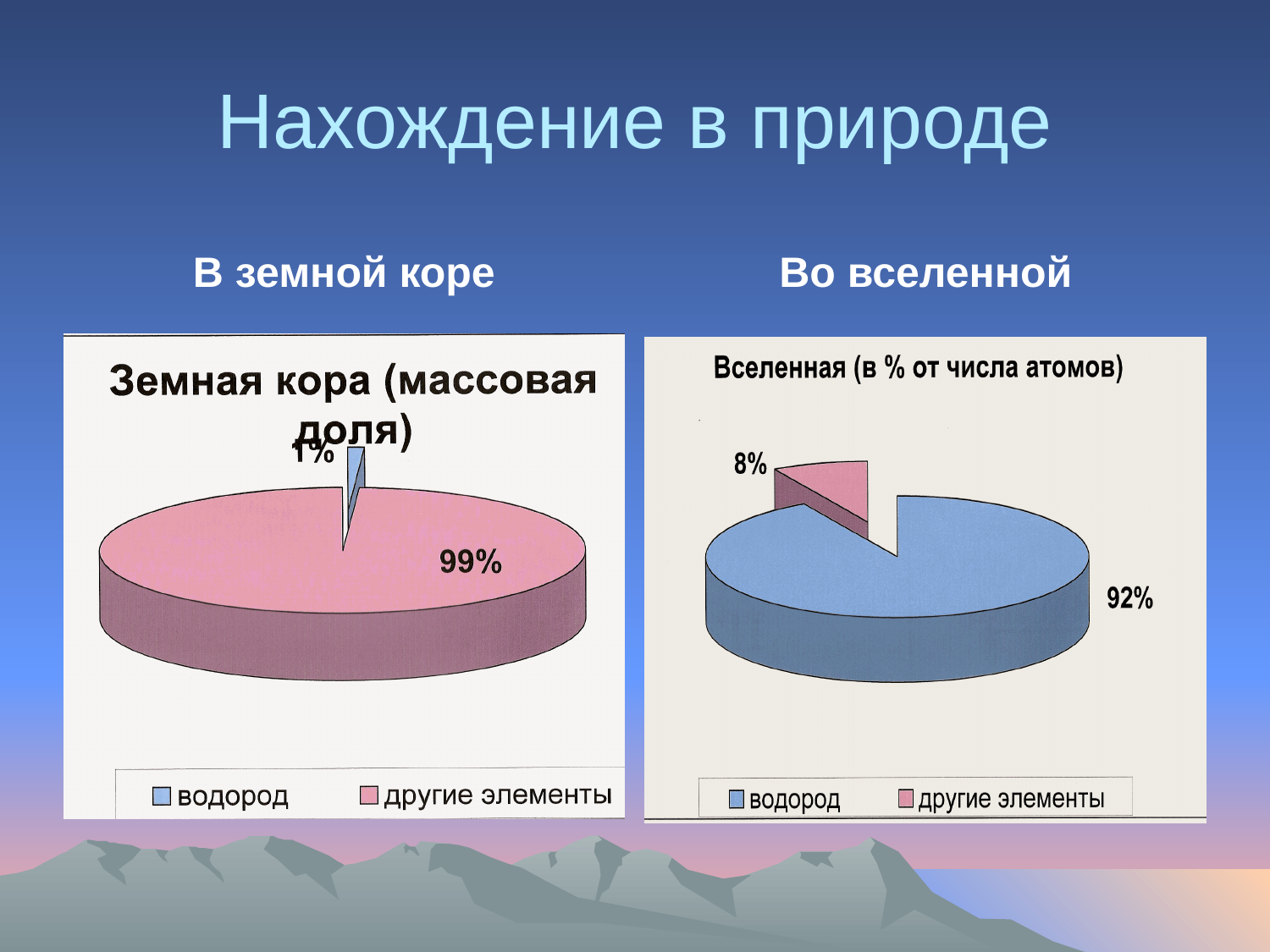
In the left chart 'Земная кора (массовая доля)', what is the difference between the shares of 'другие элементы' and 'водород'? 98% In the right chart 'Вселенная (в % от числа атомов)', what colour is the 'водород' slice? blue Which chart shows a larger share for 'водород': the left chart 'Земная кора (массовая доля)' or the right chart 'Вселенная (в % от числа атомов)'? Вселенная (в % от числа атомов) In the right chart 'Вселенная (в % от числа атомов)', what share does 'водород' have? 92% In the right chart 'Вселенная (в % от числа атомов)', what is the difference between the shares of 'водород' and 'другие элементы'? 84% In the left chart 'Земная кора (массовая доля)', what share does 'другие элементы' have? 99% In the right chart 'Вселенная (в % от числа атомов)', which category has the smallest slice? другие элементы What type of chart is the left chart 'Земная кора (массовая доля)'? pie chart In the right chart 'Вселенная (в % от числа атомов)', what share does 'другие элементы' have? 8% How many categories does the legend of the right chart 'Вселенная (в % от числа атомов)' list? 2 In the left chart 'Земная кора (массовая доля)', which category has the largest slice? другие элементы In the left chart 'Земная кора (массовая доля)', what share does 'водород' have? 1%